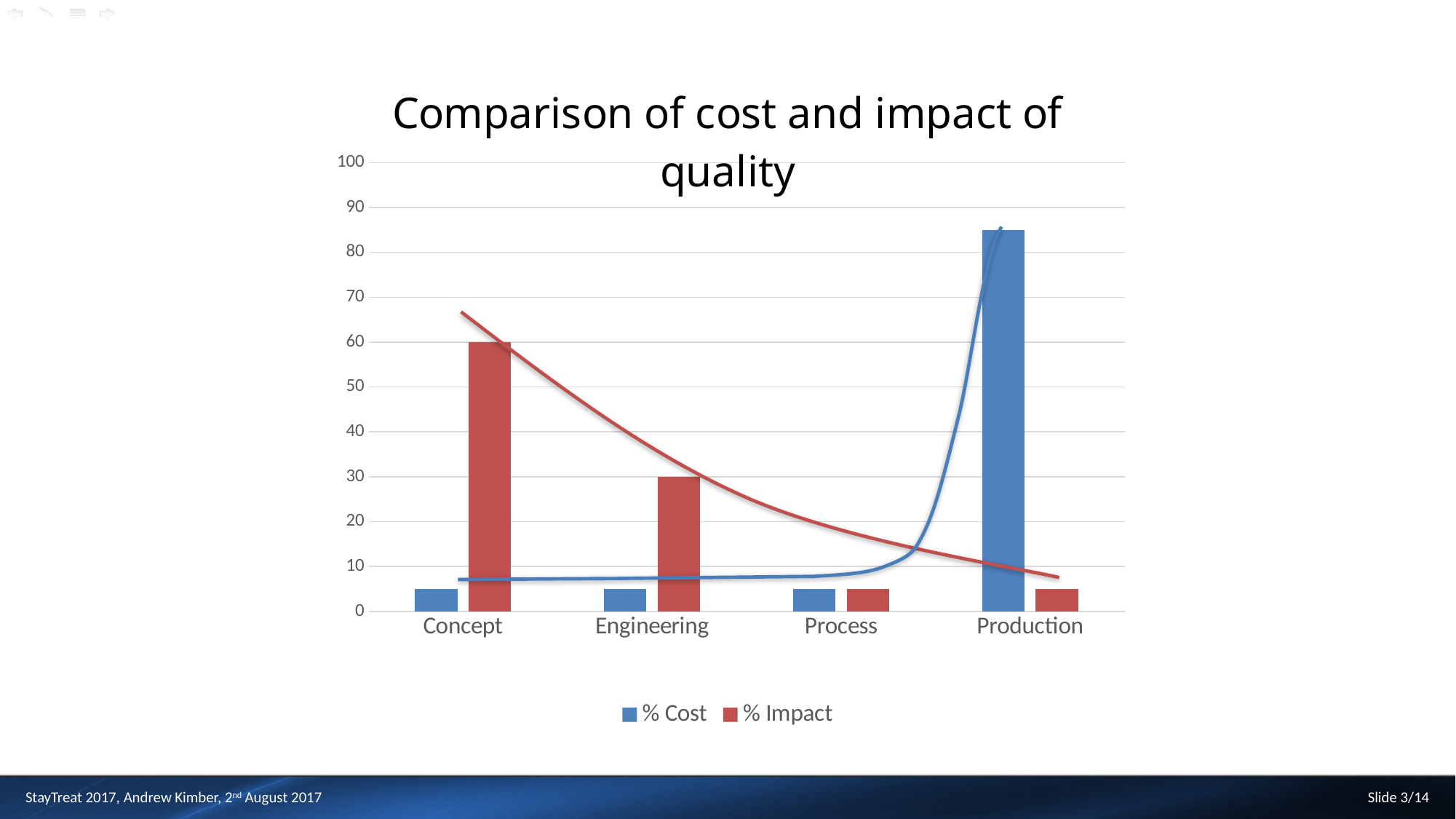
Is the % Cost value for Production greater or less than 80? greater What is the title of the chart? Comparison of cost and impact of quality Is the % Cost value for Process greater or less than 10? less What is the difference between the % Impact values for Concept and Engineering? 30 Do the % Impact values rise or fall from Concept to Production? fall How many categories are shown on the x axis? 4 What is the % Impact value for Engineering? 30 How many series does the legend list? 2 What type of chart is shown on the slide? bar chart Which category has the highest % Impact value? Concept Which category has the highest % Cost value? Production What is the % Impact value for Concept? 60